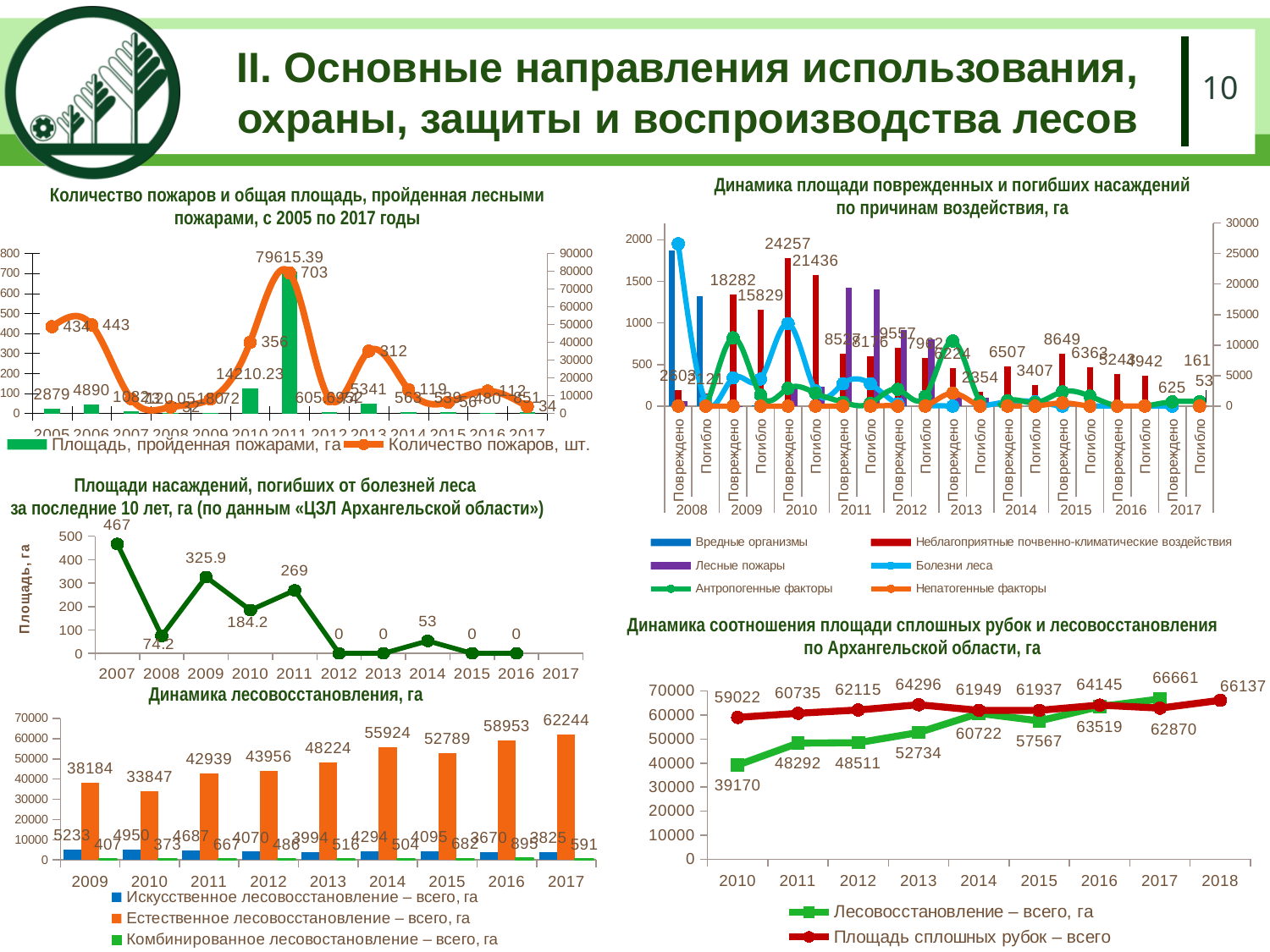
In the chart 'Количество пожаров и общая площадь, пройденная лесными пожарами, с 2005 по 2017 годы', what is the value of 'Количество пожаров, шт.' for 2011? 703 In the chart 'Динамика лесовосстановления, га', what kind of chart is it? bar chart In the chart 'Площади насаждений, погибших от болезней леса за последние 10 лет, га', which is larger: the value for 2011 or the value for 2010? 2011 In the chart 'Динамика площади поврежденных и погибших насаждений по причинам воздействия, га', how many series does the legend list? 6 In the chart 'Динамика соотношения площади сплошных рубок и лесовосстановления по Архангельской области, га', what is the value of 'Площадь сплошных рубок – всего' for 2018? 66137 In the chart 'Динамика соотношения площади сплошных рубок и лесовосстановления по Архангельской области, га', how many series does the legend list? 2 In the chart 'Площади насаждений, погибших от болезней леса за последние 10 лет, га', what is the value for 2009? 325.9 In the chart 'Динамика лесовосстановления, га', what is the difference between the 'Естественное лесовосстановление' values for 2016 and 2015? 6164 In the chart 'Динамика соотношения площади сплошных рубок и лесовосстановления по Архангельской области, га', what is the value of 'Лесовосстановление – всего, га' for 2010? 39170 In the chart 'Площади насаждений, погибших от болезней леса за последние 10 лет, га', which year has the highest value? 2007 In the chart 'Динамика лесовосстановления, га', what is the value of 'Естественное лесовосстановление – всего, га' for 2017? 62244 In the chart 'Динамика лесовосстановления, га', which year has the lowest value for 'Естественное лесовосстановление – всего, га'? 2010